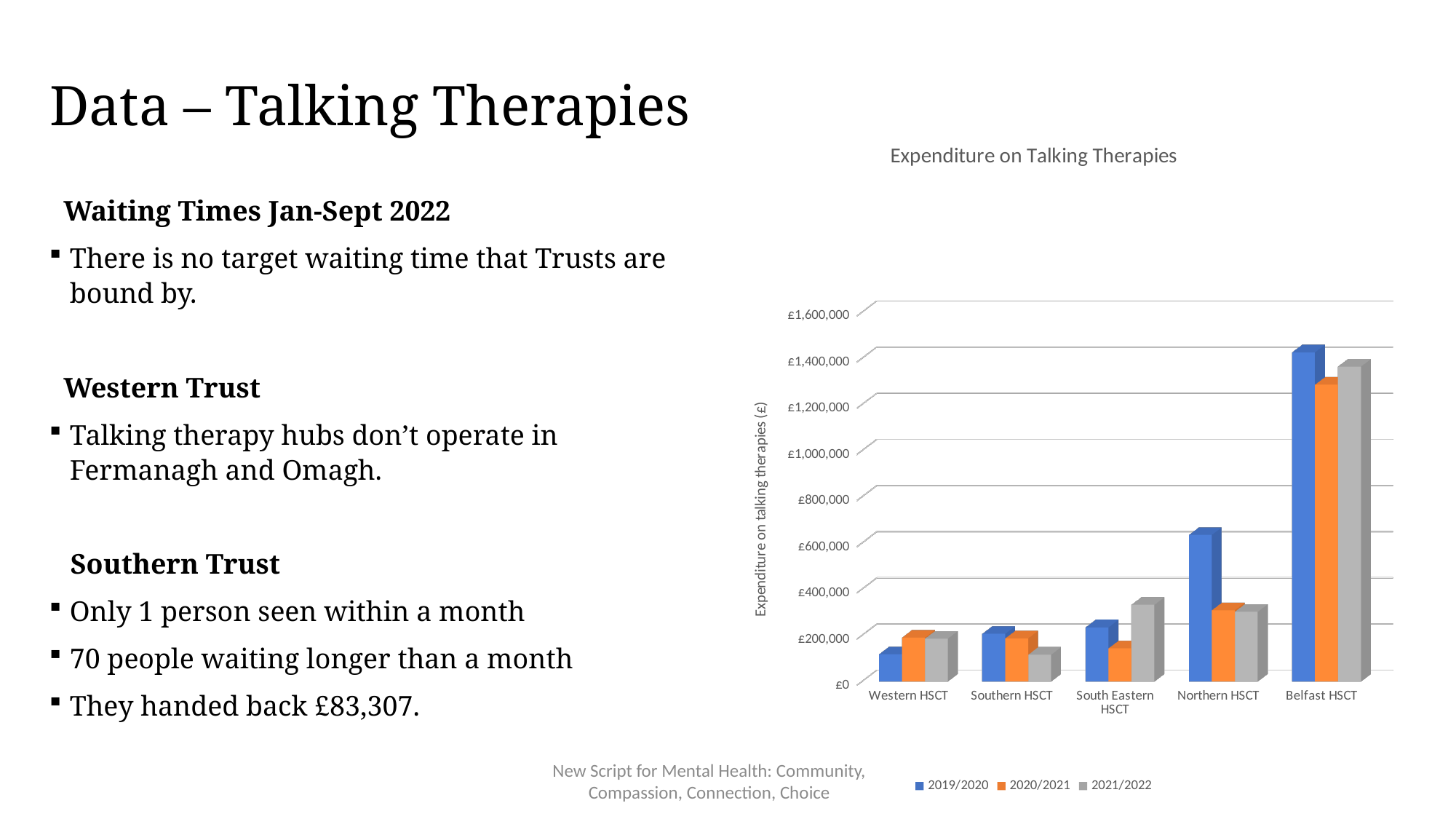
For Belfast HSCT, which is larger: the 2019/2020 expenditure or the 2020/2021 expenditure? 2019/2020 Is the 2019/2020 expenditure for Belfast HSCT greater or less than £1,200,000? greater What is the title of the vertical axis on the Expenditure on Talking Therapies chart? Expenditure on talking therapies (£) Is the 2019/2020 expenditure for Western HSCT greater or less than £200,000? less How many trusts (categories) are shown on the x axis of the Expenditure on Talking Therapies chart? 5 Which trust has the highest 2019/2020 expenditure on talking therapies? Belfast HSCT For Northern HSCT, which is larger: the 2019/2020 expenditure or the 2021/2022 expenditure? 2019/2020 What kind of chart is shown on the slide? Bar chart For South Eastern HSCT, which is larger: the 2020/2021 expenditure or the 2021/2022 expenditure? 2021/2022 How many series does the legend of the Expenditure on Talking Therapies chart list? 3 Is the 2019/2020 expenditure for Northern HSCT greater or less than £400,000? greater Which trust has the lowest 2019/2020 expenditure on talking therapies? Western HSCT